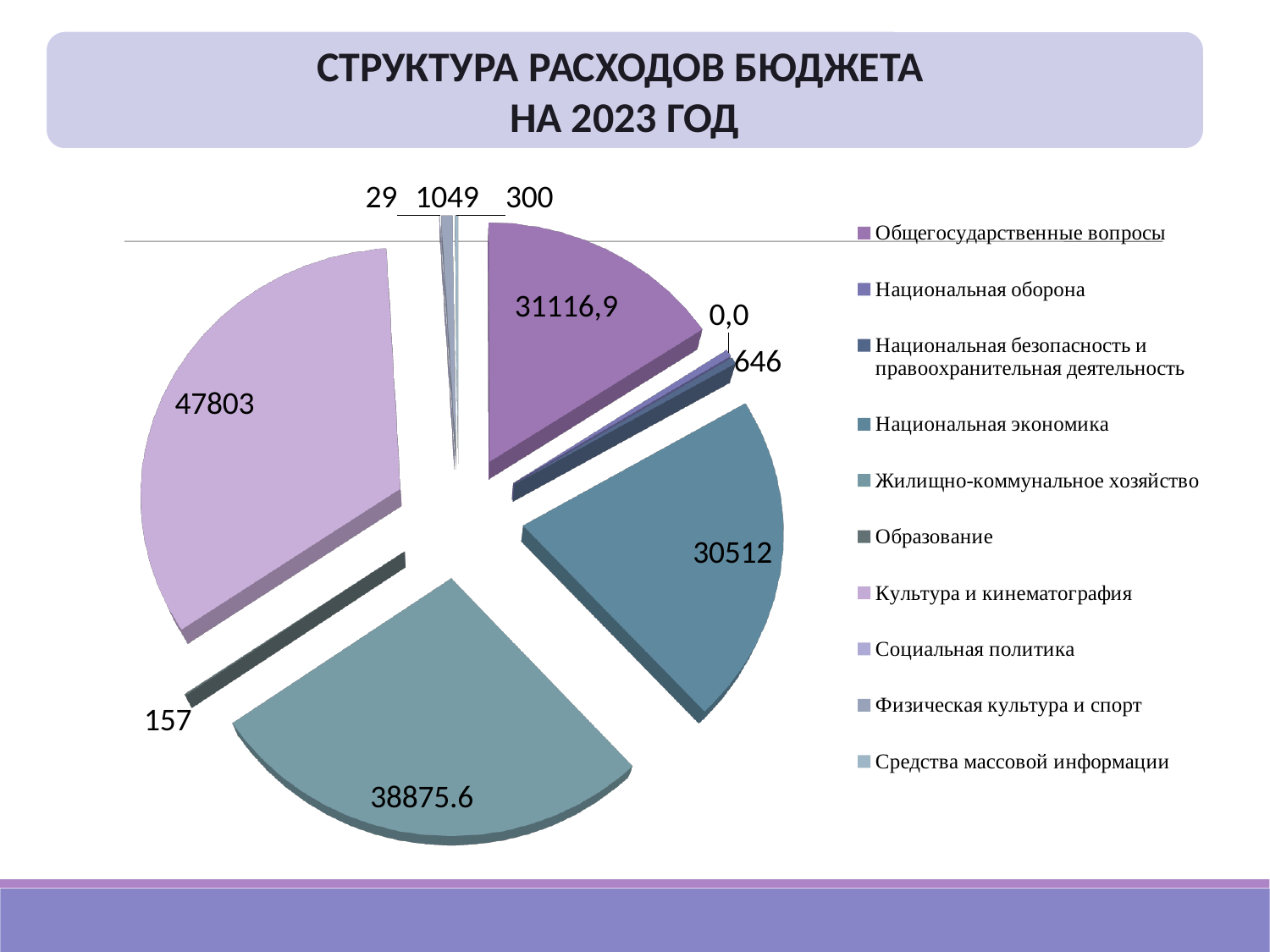
What is the value for Национальная безопасность и правоохранительная деятельность? 646 Which is larger: Национальная экономика or Жилищно-коммунальное хозяйство? Жилищно-коммунальное хозяйство What kind of chart is shown on the slide? Pie chart What is the difference between the values for Культура и кинематография and Жилищно-коммунальное хозяйство? 8927.4 What is the value for Культура и кинематография? 47803 What is the value for Национальная экономика? 30512 How many categories does the legend list? 10 What is the value for Жилищно-коммунальное хозяйство? 38875.6 Which category has the largest slice of the pie? Культура и кинематография What is the value for Образование? 157 What is the value for Общегосударственные вопросы? 31116,9